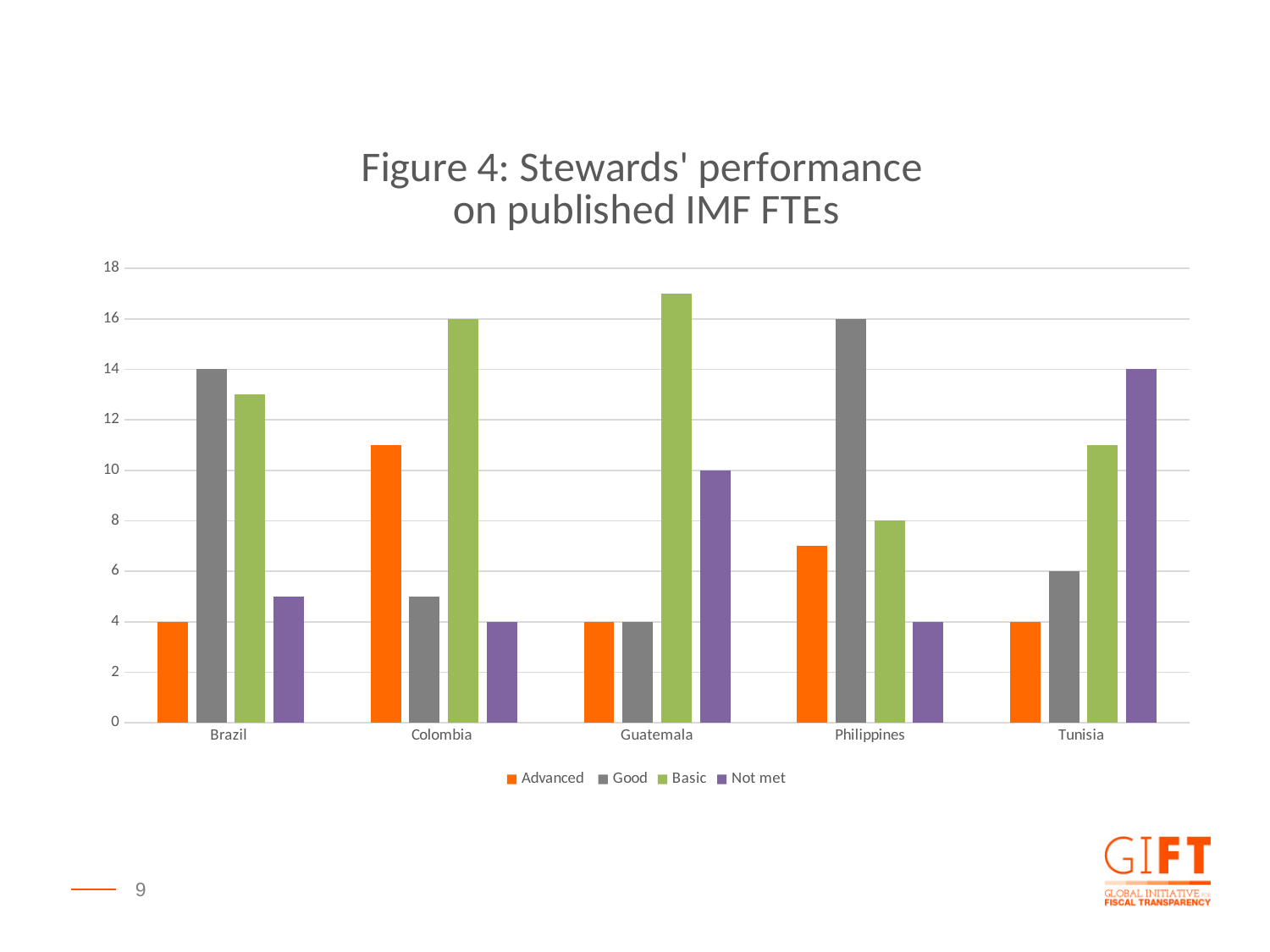
Is the Basic value for Guatemala greater or less than 16? greater What is the value of the Not met bar for Tunisia? 14 Which country has the highest Basic value? Guatemala What is the value of the Basic bar for Colombia? 16 How many countries are shown on the x axis? 5 What is the difference between the Good and Basic values for the Philippines? 8 How many series does the legend list? 4 What is the value of the Good bar for Brazil? 14 What kind of chart is shown on the slide? bar chart What is the value of the Not met bar for Guatemala? 10 Is the Advanced value for Colombia greater or less than 10? greater For Tunisia, which is larger: the Basic bar or the Not met bar? Not met